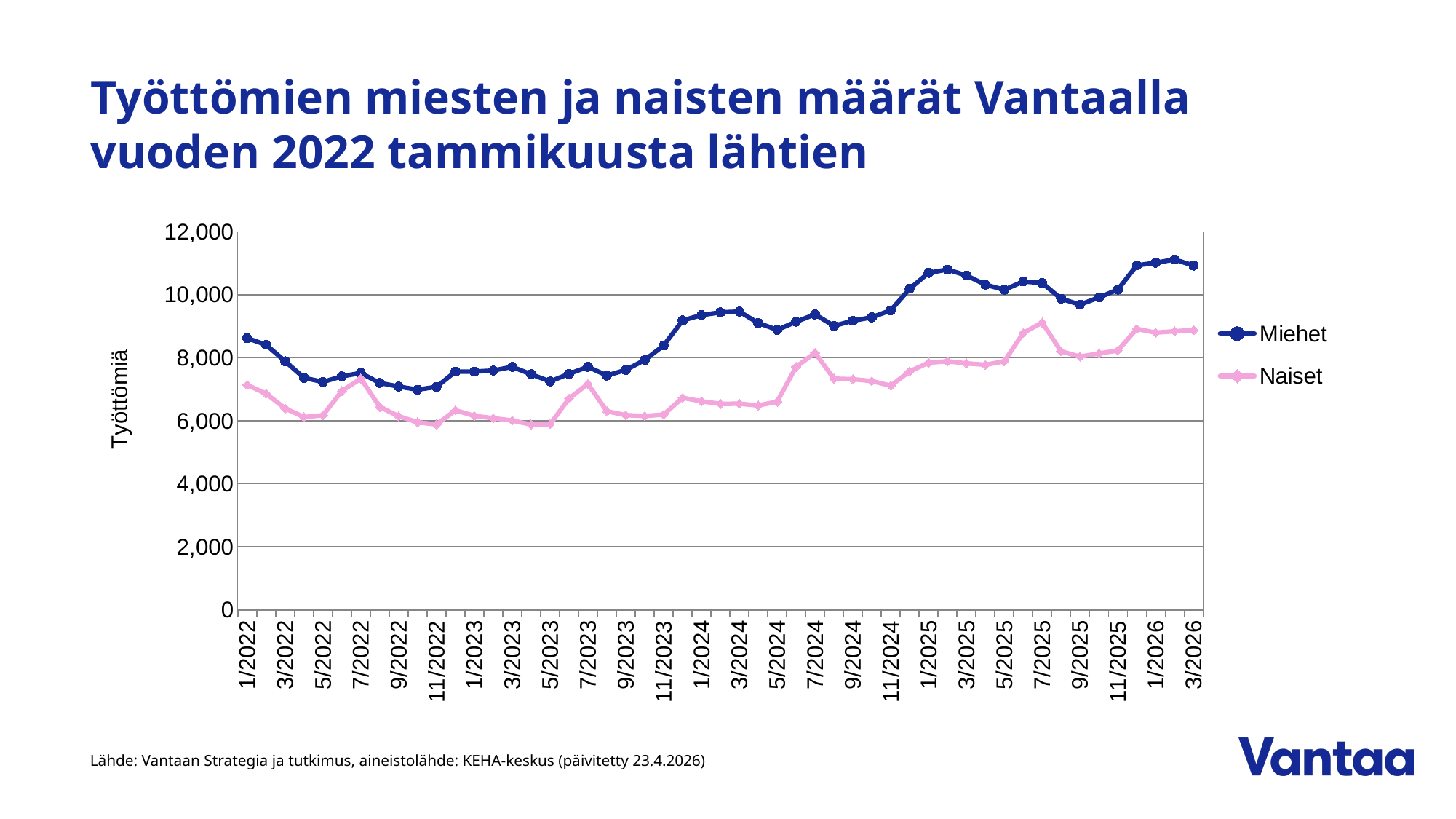
What is the label on the vertical axis? Työttömiä Is the value for Miehet in 3/2026 greater or less than 10,000? greater Overall, does the Miehet series rise or fall from 1/2022 to 3/2026? Rise Is the value for Naiset in 3/2026 greater or less than 10,000? less How many series does the legend list? 2 What kind of chart is shown on the slide? Line chart Does the Naiset series rise or fall from 1/2022 to 9/2022? Fall Is the value for Miehet in 1/2022 greater or less than 8,000? greater What are the two series named in the legend? Miehet and Naiset Which series has the higher value in 1/2024, Miehet or Naiset? Miehet